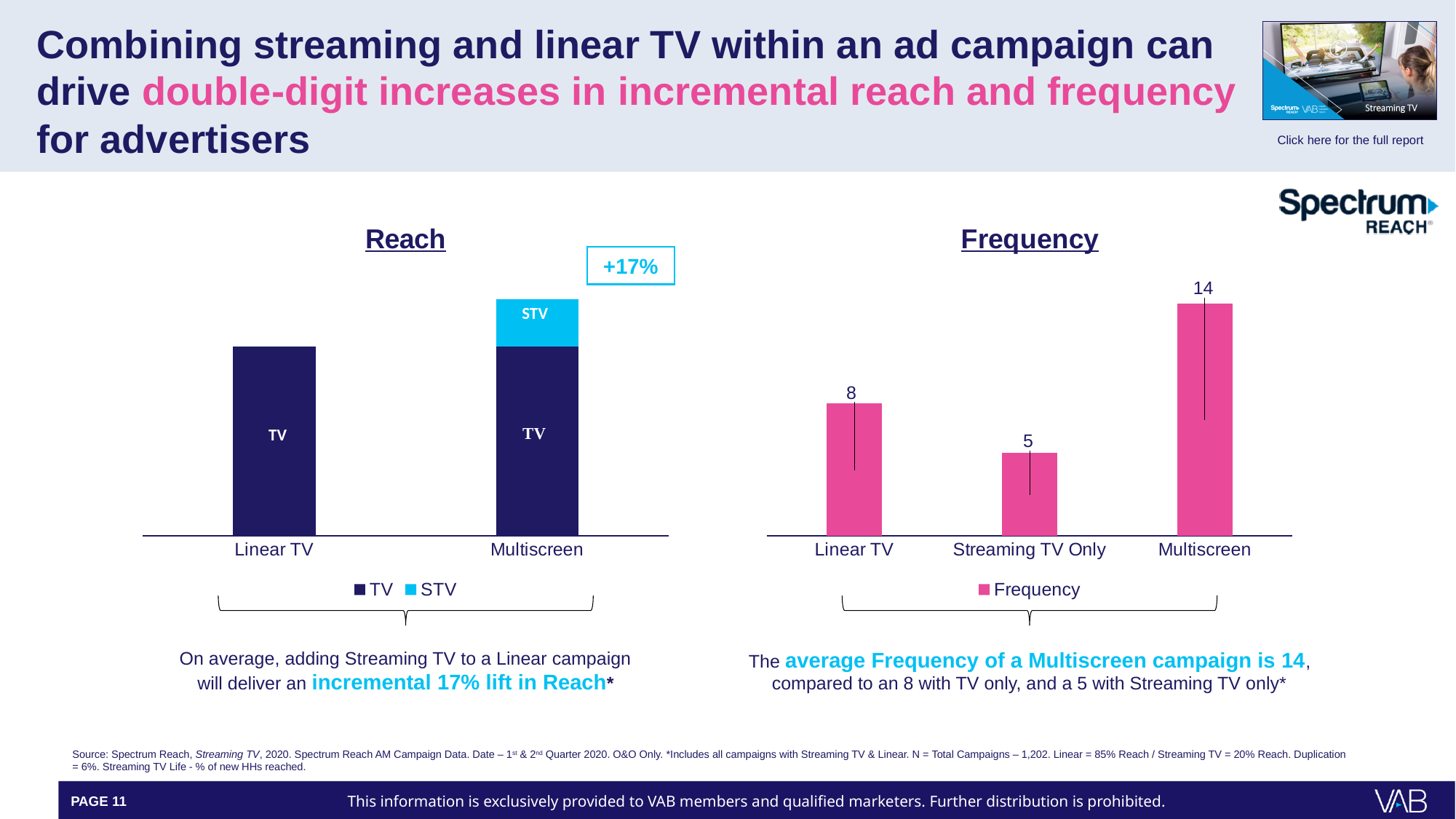
In the Frequency chart, what is the value for Multiscreen? 14 In the Reach chart, which bar is taller overall, Linear TV or Multiscreen? Multiscreen In the Frequency chart, what is the difference between the Linear TV value and the Streaming TV Only value? 3 In the Frequency chart, what is the difference between the Multiscreen value and the Linear TV value? 6 In the Frequency chart, which category has the lowest value? Streaming TV Only In the Frequency chart, what is the value for Linear TV? 8 In the Frequency chart, which category has the highest value? Multiscreen In the Reach chart, what are the two legend entries? TV and STV What kind of chart is the Reach chart? Stacked bar chart In the Frequency chart, how many categories are shown on the x axis? 3 In the Frequency chart, what is the value for Streaming TV Only? 5 In the Reach chart, how many series does the legend list? 2